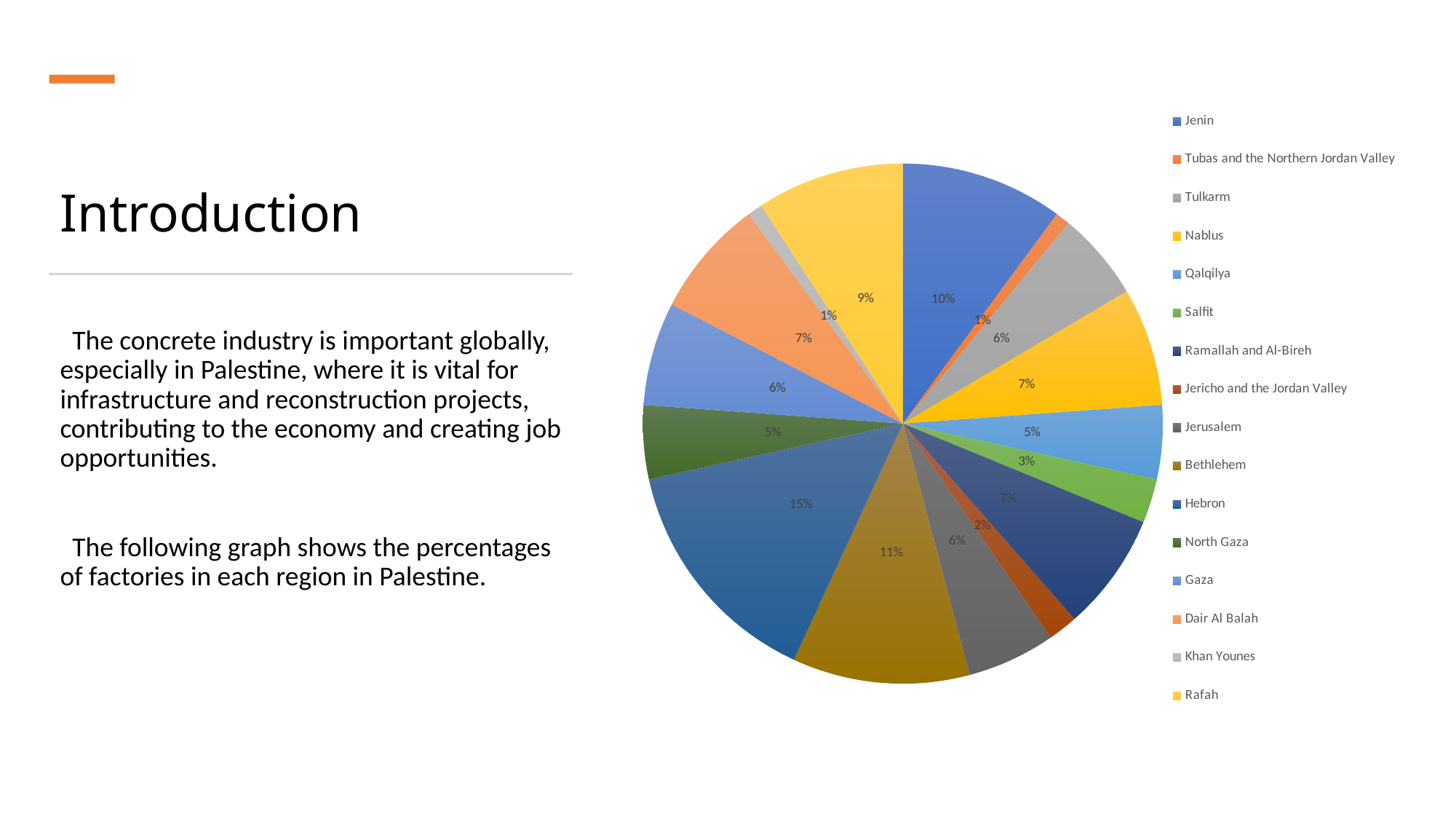
What percentage of factories is in Salfit? 3% What kind of chart is shown on the slide? pie chart What percentage of factories is in Bethlehem? 11% What percentage of factories is in Jericho and the Jordan Valley? 2% Which region has a larger share of factories, Jenin or Rafah? Jenin Which region has the largest share of factories? Hebron What percentage of factories is in Rafah? 9% What percentage of factories is in Jenin? 10% What percentage of factories is in Hebron? 15% Which region is listed first in the legend of the pie chart? Jenin By how many percentage points does Hebron's share exceed Bethlehem's share? 4 percentage points How many regions does the legend of the pie chart list? 16